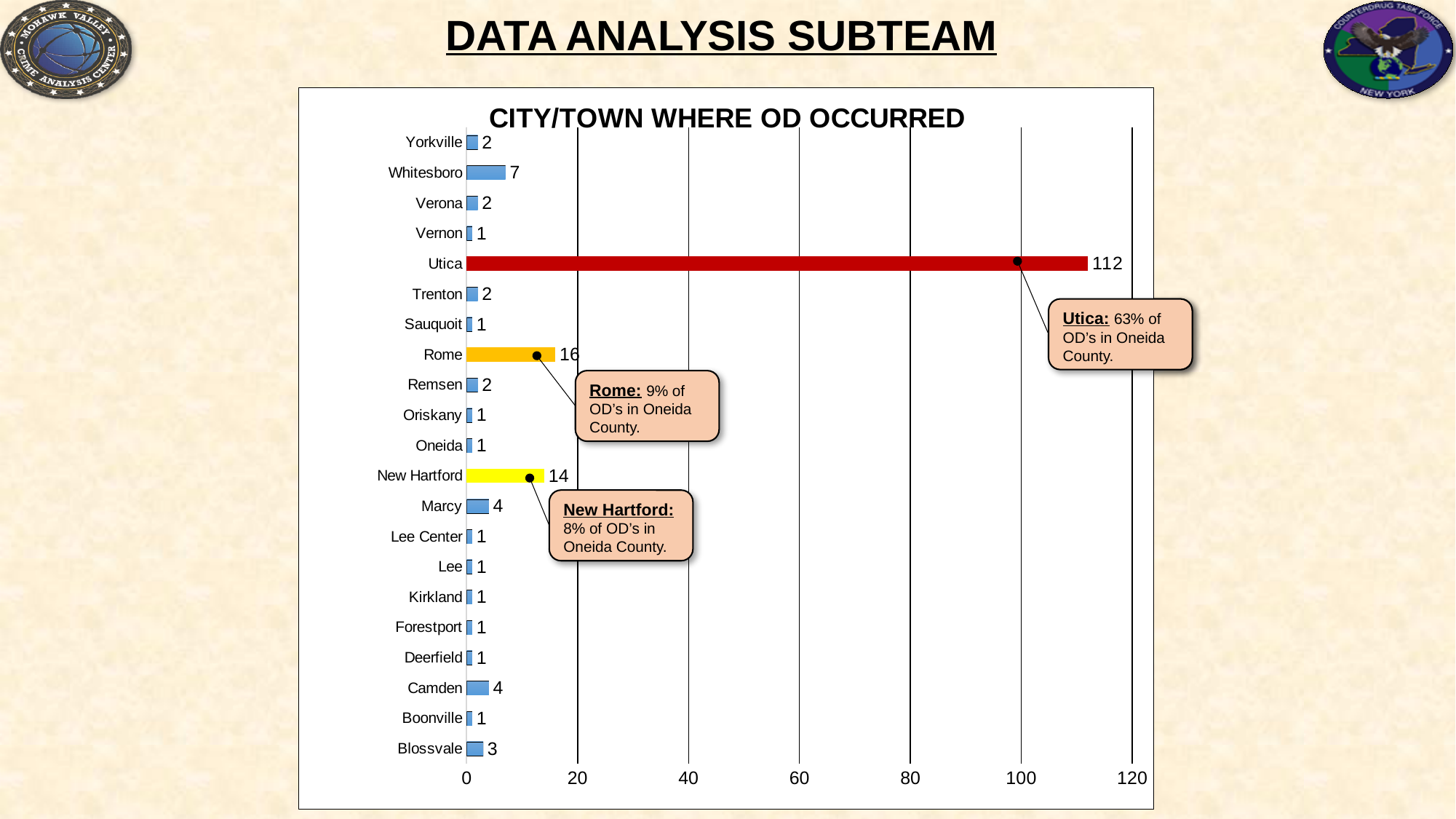
What is the value for New Hartford? 14 How many cities/towns are shown on the chart? 21 Is the value for Utica greater or less than 100? greater Which has a larger value, Whitesboro or Marcy? Whitesboro According to the callout, what percentage of OD's in Oneida County occurred in Utica? 63% What is the value for Utica? 112 What is the value for Rome? 16 What is the difference between the values for Rome and New Hartford? 2 What is the difference between the values for Utica and Rome? 96 What kind of chart is shown? bar chart What is the value for Whitesboro? 7 Which city/town has the highest value? Utica